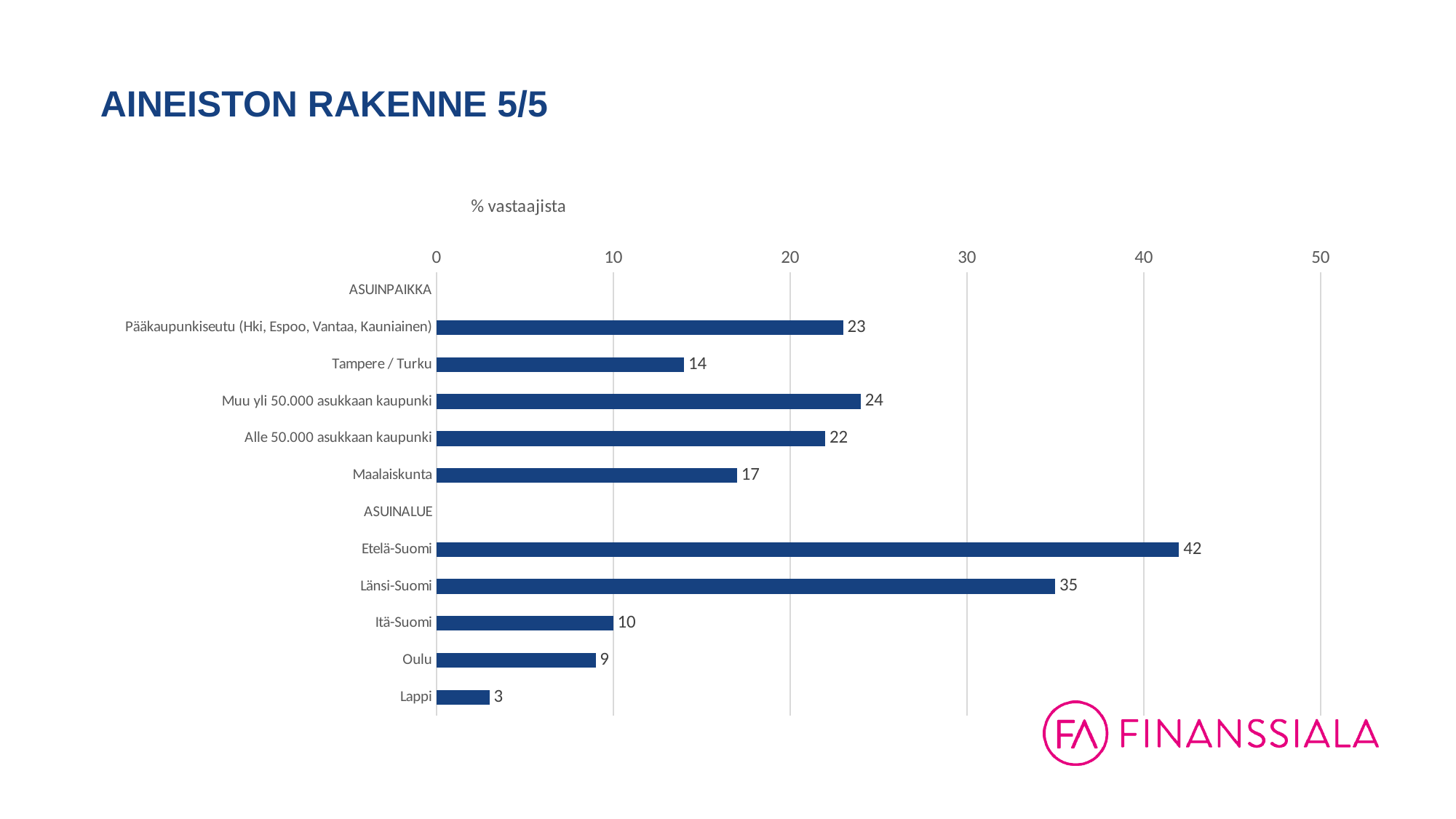
Which is larger, the value for Pääkaupunkiseutu (Hki, Espoo, Vantaa, Kauniainen) or the value for Maalaiskunta? Pääkaupunkiseutu (Hki, Espoo, Vantaa, Kauniainen) How many bars with values are plotted in the chart? 10 Which category has the lowest value? Lappi What is the title of the chart? % vastaajista What is the value for Maalaiskunta? 17 Is the value for Länsi-Suomi greater or less than 30? greater What is the difference between the values for Muu yli 50.000 asukkaan kaupunki and Alle 50.000 asukkaan kaupunki? 2 Which category has the highest value? Etelä-Suomi What is the value for Etelä-Suomi? 42 What kind of chart is shown on the slide? bar chart What is the value for Tampere / Turku? 14 What is the difference between the values for Etelä-Suomi and Länsi-Suomi? 7